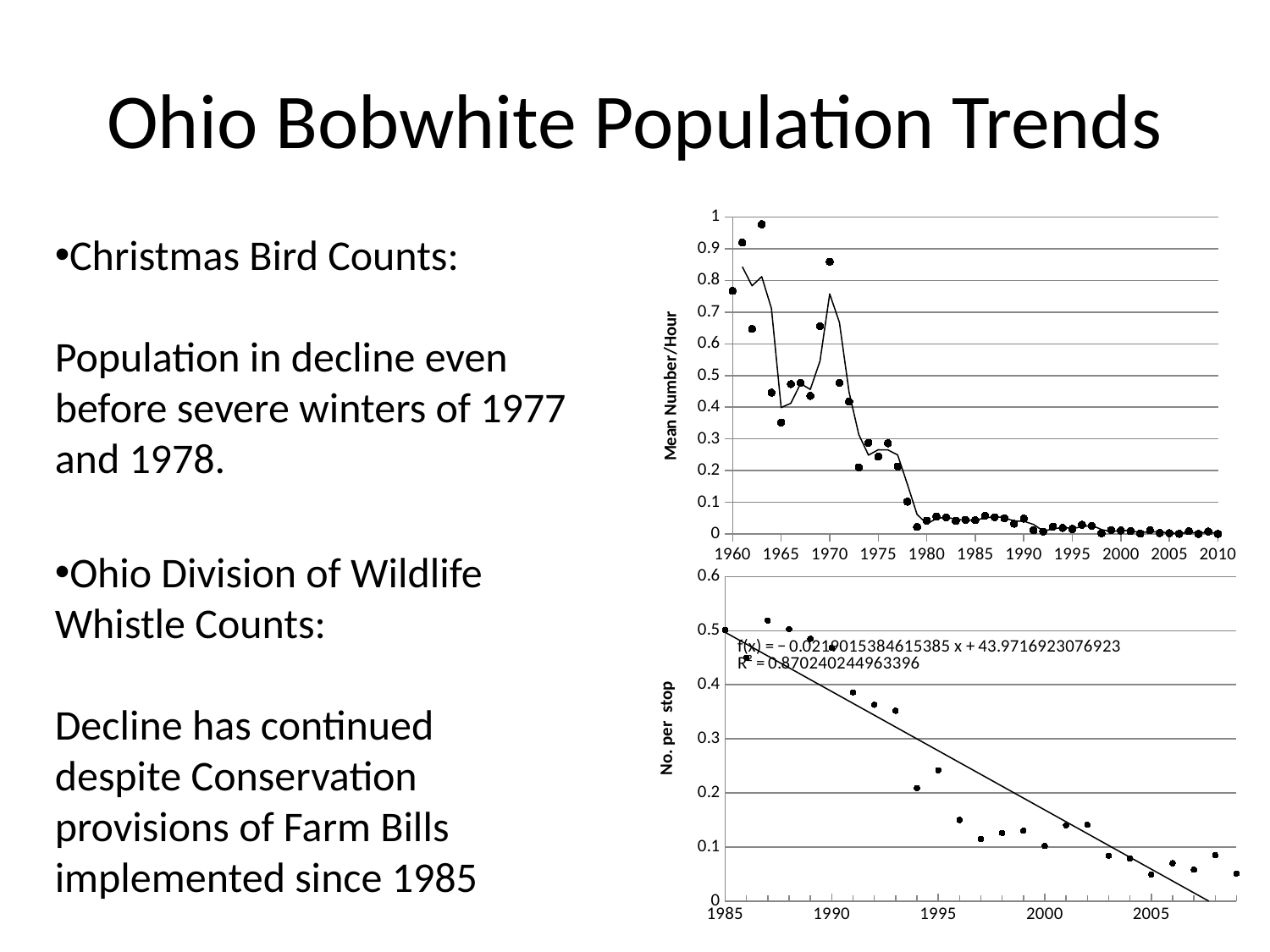
In the top chart (Mean Number/Hour), is the value for 1980 greater or less than 0.1? less In the bottom chart (No. per stop), do the values generally rise or fall from 1985 to 2009? fall In the bottom chart (No. per stop), which year has the larger value, 1985 or 2005? 1985 In the top chart (Mean Number/Hour), is the value for 1960 greater or less than 0.7? greater In the bottom chart (No. per stop), is the value for 1985 greater or less than 0.4? greater What kind of chart is the top chart (Mean Number/Hour)? scatter chart What R² value is shown for the trendline in the bottom chart (No. per stop)? 0.870240244963396 In the top chart (Mean Number/Hour), do the values generally rise or fall from 1960 to 2010? fall In the top chart (Mean Number/Hour), which year has the larger value, 1960 or 2000? 1960 What is the y-axis title of the top chart? Mean Number/Hour